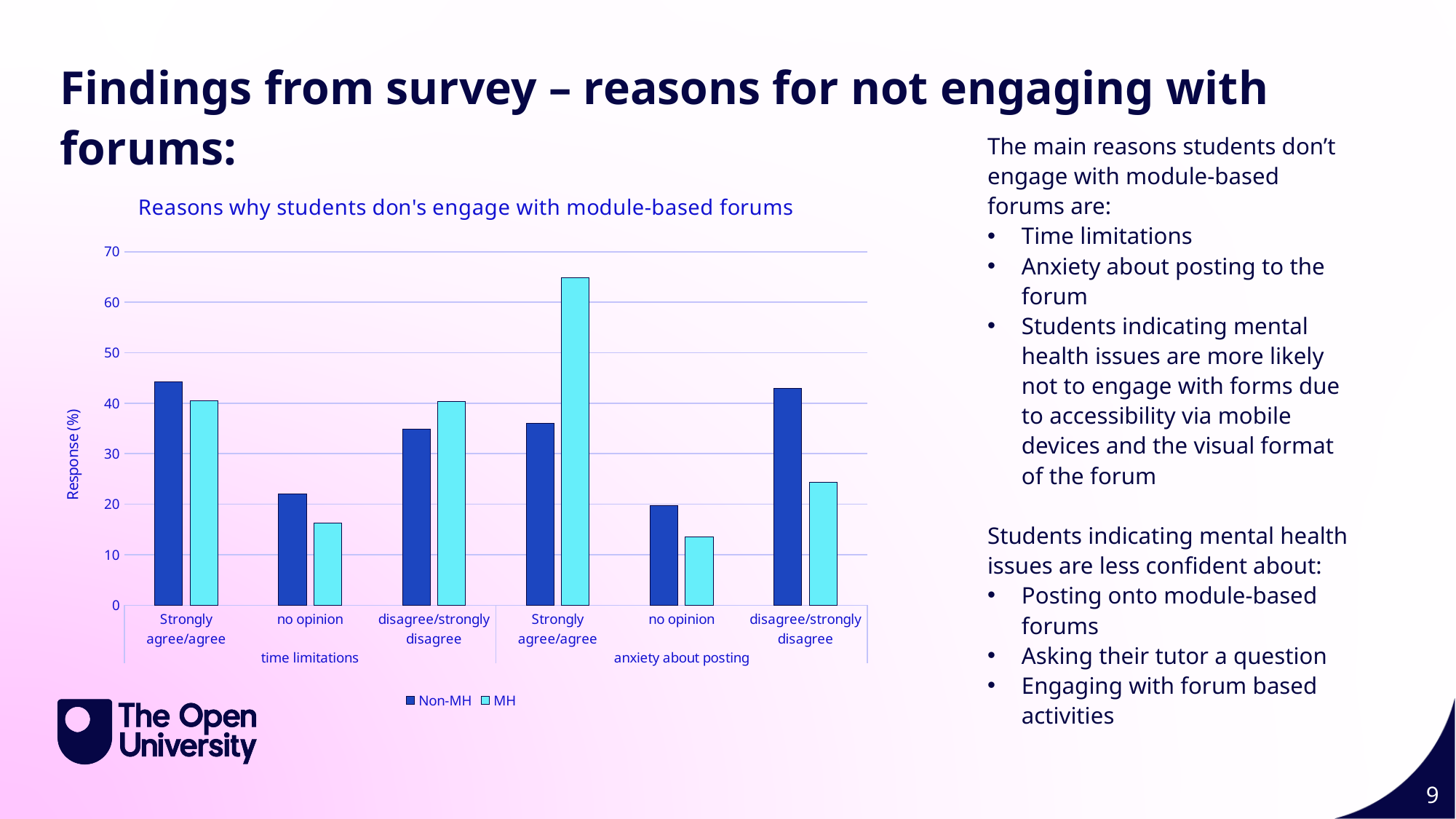
How many response categories are shown along the x axis of the chart? 6 What is the title of the chart? Reasons why students don's engage with module-based forums For disagree/strongly disagree under anxiety about posting, which series has the larger value, Non-MH or MH? Non-MH Is the Non-MH value for disagree/strongly disagree under anxiety about posting greater or less than 40? greater Is the MH value for Strongly agree/agree under anxiety about posting greater or less than 60? greater Which bar in the chart is the shortest? MH, no opinion (anxiety about posting) What kind of chart is shown on the slide? bar chart Is the Non-MH value for no opinion under time limitations greater or less than 30? less Which bar in the chart is the tallest? MH, Strongly agree/agree (anxiety about posting) For Strongly agree/agree under anxiety about posting, which series has the larger value, Non-MH or MH? MH What are the two series named in the chart legend? Non-MH and MH How many series does the chart legend list? 2